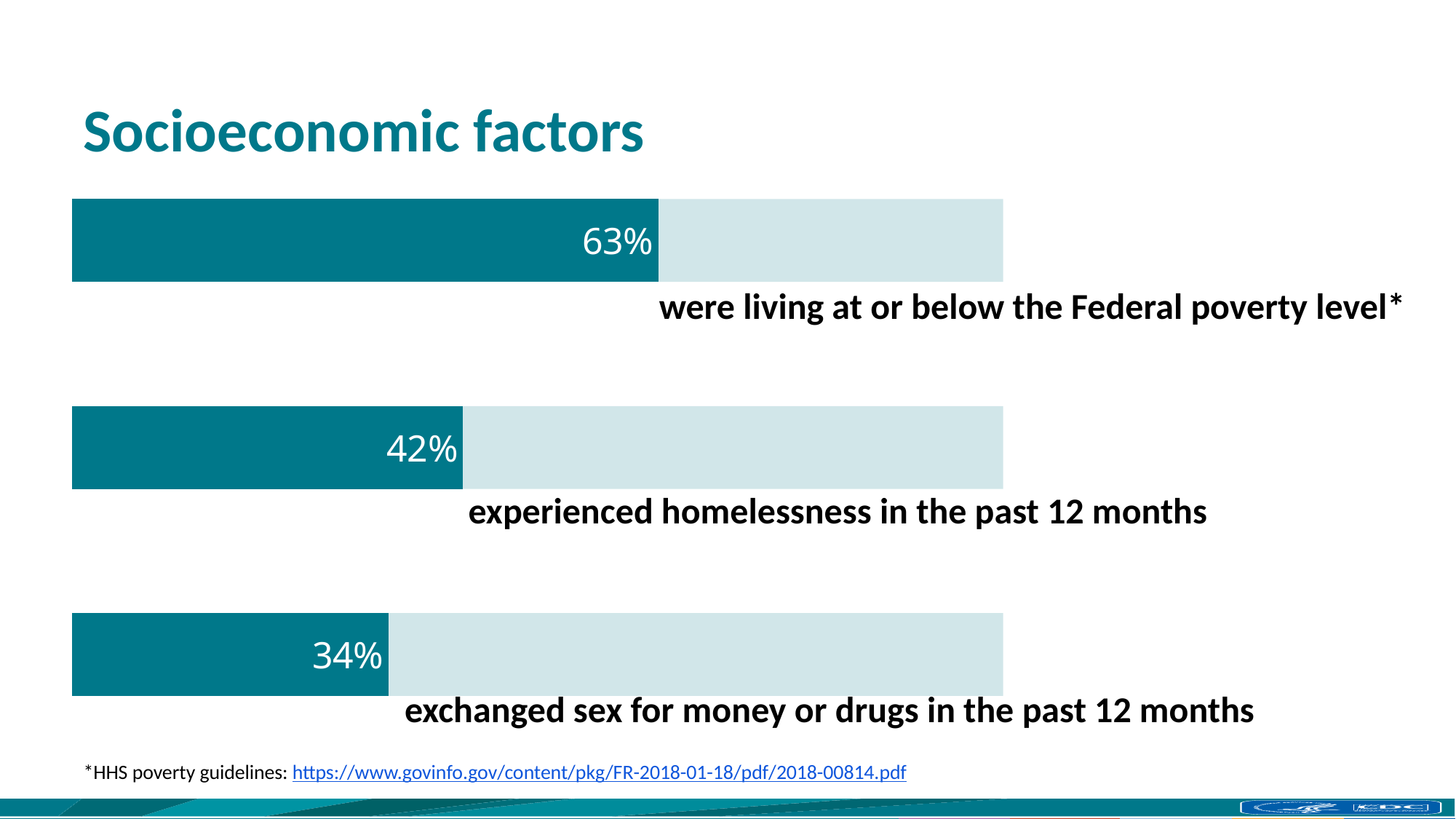
What is the title of the slide? Socioeconomic factors What kind of chart is used on the slide? bar chart Which is larger: the percentage who experienced homelessness in the past 12 months or the percentage who exchanged sex for money or drugs in the past 12 months? experienced homelessness in the past 12 months How many socioeconomic factors are shown as bars on the slide? 3 What percentage were living at or below the Federal poverty level? 63% What is the difference between the percentage who experienced homelessness and the percentage who exchanged sex for money or drugs in the past 12 months? 8% Which socioeconomic factor has the highest percentage? were living at or below the Federal poverty level What colour are the filled portions of the bars? teal Which socioeconomic factor has the lowest percentage? exchanged sex for money or drugs in the past 12 months What percentage experienced homelessness in the past 12 months? 42% What percentage exchanged sex for money or drugs in the past 12 months? 34% What is the difference between the percentage living at or below the Federal poverty level and the percentage who experienced homelessness in the past 12 months? 21%